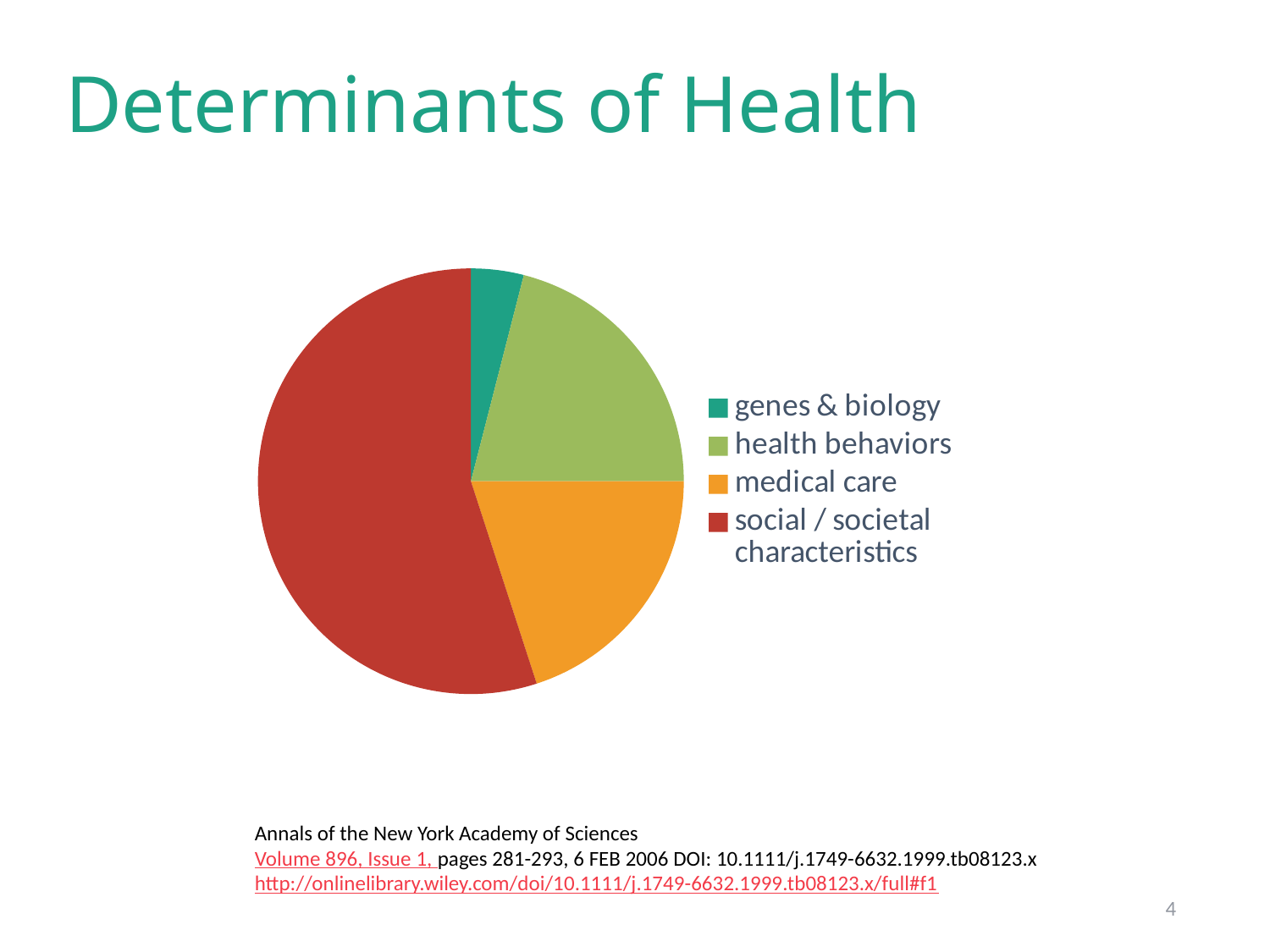
Does the social / societal characteristics slice take up more or less than half of the pie? more What kind of chart is shown on the slide? pie chart Which slice is larger: health behaviors or genes & biology? health behaviors Which category has the smallest slice of the pie chart? genes & biology Which slice is larger: social / societal characteristics or health behaviors? social / societal characteristics Which category has the largest slice of the pie chart? social / societal characteristics What colour is the medical care slice in the pie chart? orange What is the title of the slide containing the pie chart? Determinants of Health How many categories does the pie chart show? 4